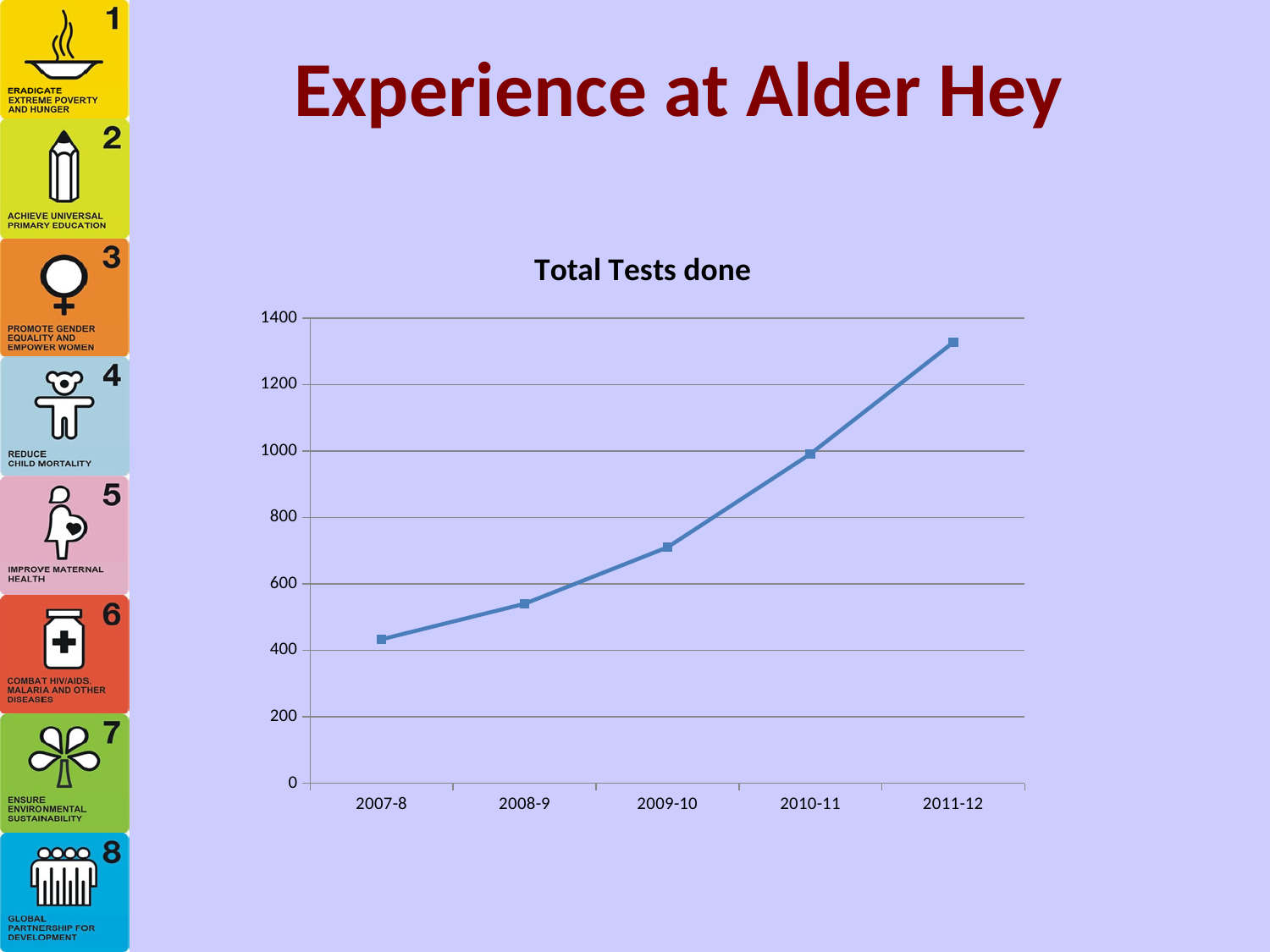
Is the value for 2008-9 greater or less than 600? less What is the title of the chart? Total Tests done Is the value for 2011-12 greater or less than 1200? greater Which period has the highest number of total tests done? 2011-12 Is the value for 2009-10 greater or less than 800? less What is the first period shown on the x axis? 2007-8 Which period has the lowest number of total tests done? 2007-8 Do the values rise or fall from 2007-8 to 2011-12? rise What kind of chart is shown on the slide? line chart Which is larger, the value for 2010-11 or the value for 2008-9? 2010-11 How many time periods are plotted on the x axis? 5